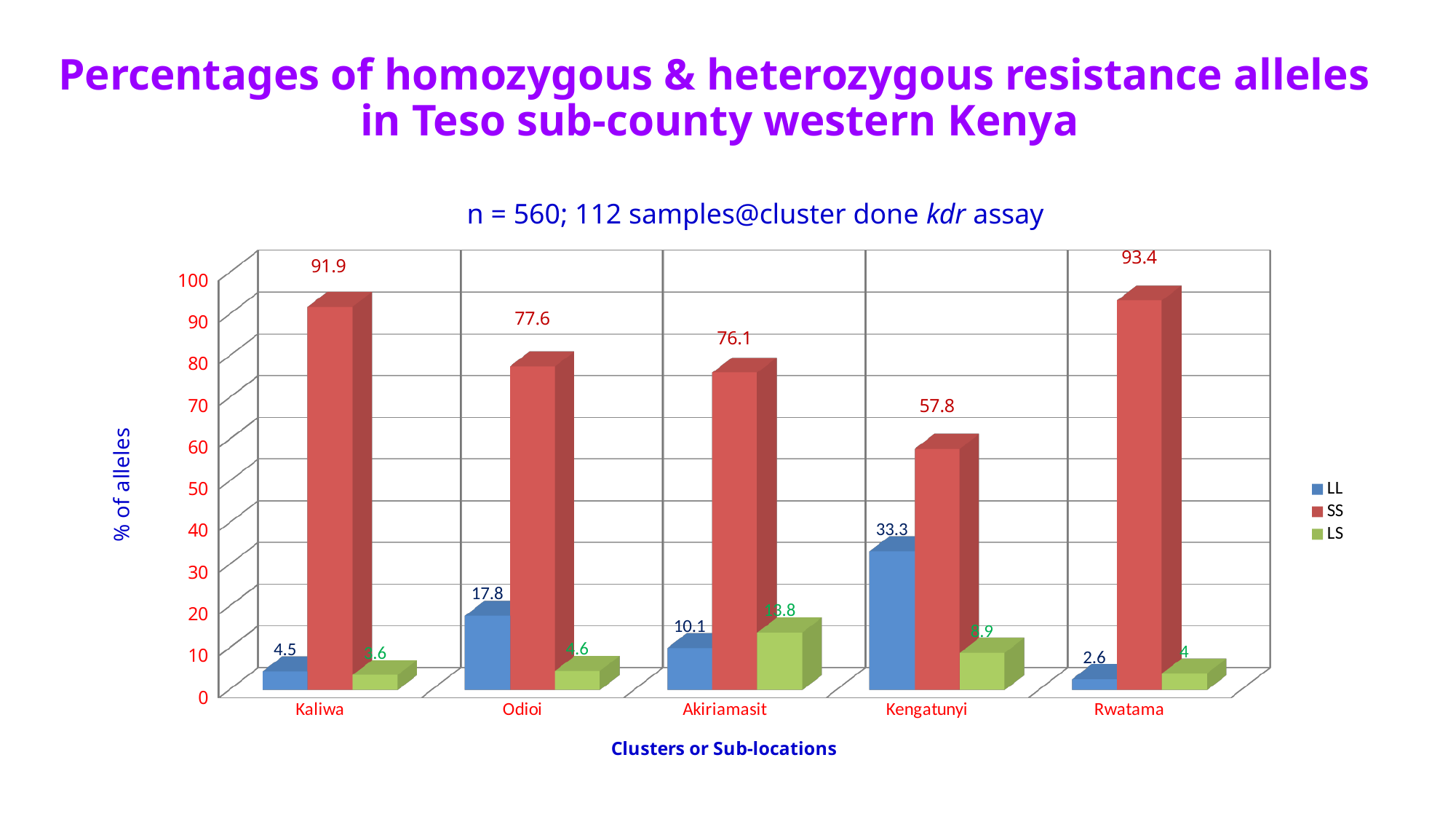
What is the title of the y axis? % of alleles Which cluster has the highest SS value? Rwatama Which has the larger LL value, Odioi or Akiriamasit? Odioi What kind of chart is shown on the slide? bar chart What is the LL value for Kengatunyi? 33.3 Which cluster has the lowest LL value? Rwatama What is the SS value for Kaliwa? 91.9 How many series does the legend list? 3 What is the difference between the SS value for Kaliwa and the SS value for Kengatunyi? 34.1 How many clusters or sub-locations are shown on the x axis? 5 What is the LS value for Akiriamasit? 13.8 Is the SS value for Odioi greater or less than 70? greater